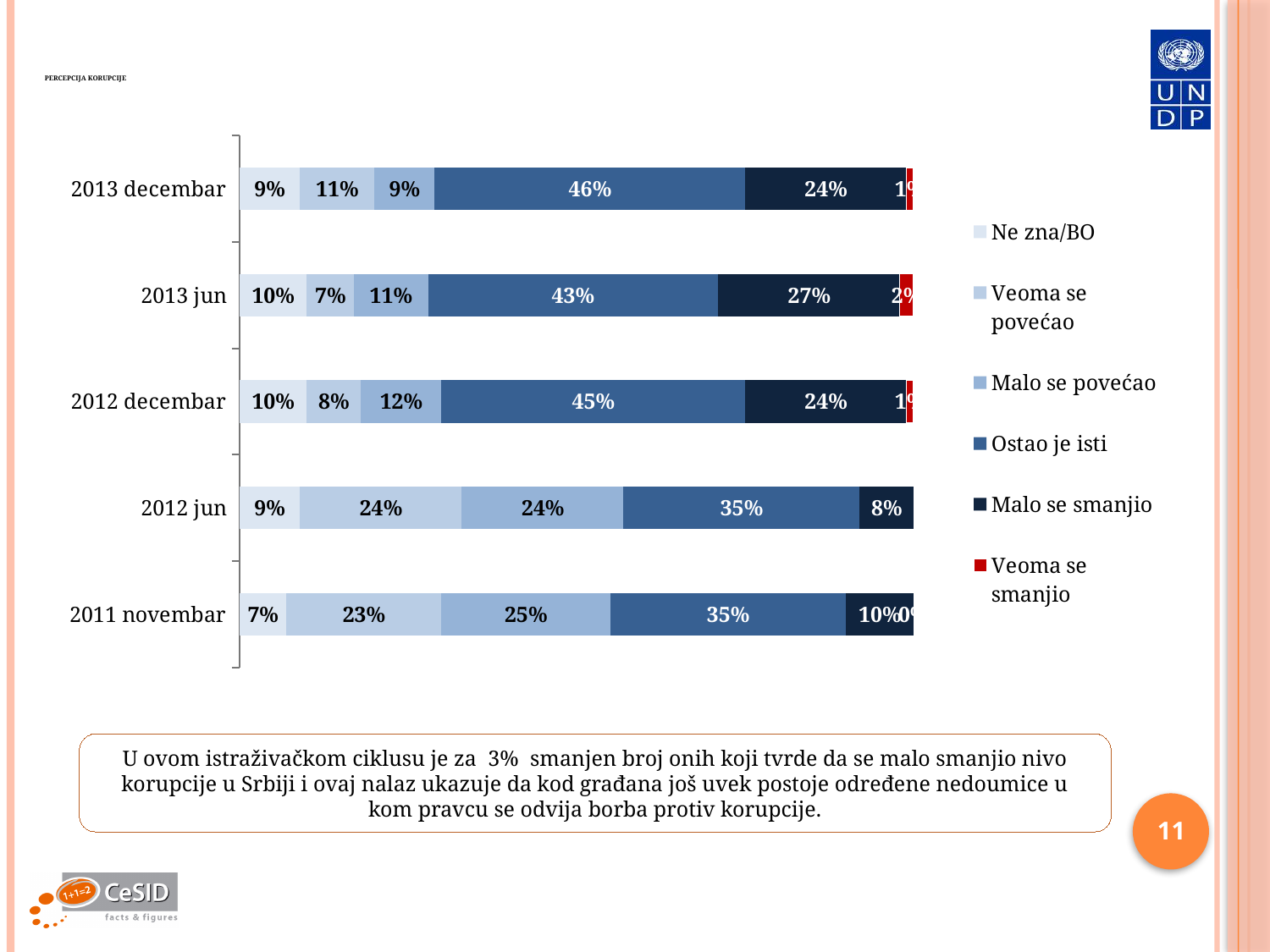
What colour represents 'Veoma se smanjio' in the legend? red How many time periods (categories) are shown on the chart? 5 What is the difference between the 'Malo se smanjio' values for 2013 jun and 2013 decembar? 3% Which period has the highest value for 'Ostao je isti'? 2013 decembar What is the value of 'Malo se smanjio' for 2013 jun? 27% What is the value of 'Ostao je isti' for 2013 decembar? 46% What is the value of 'Veoma se povećao' for 2012 jun? 24% What kind of chart is shown on the slide? bar chart Which period has the lowest value for 'Ne zna/BO'? 2011 novembar How many series does the legend list? 6 Which is larger: 'Malo se povećao' for 2011 novembar or for 2012 jun? 2011 novembar What is the value of 'Ne zna/BO' for 2011 novembar? 7%